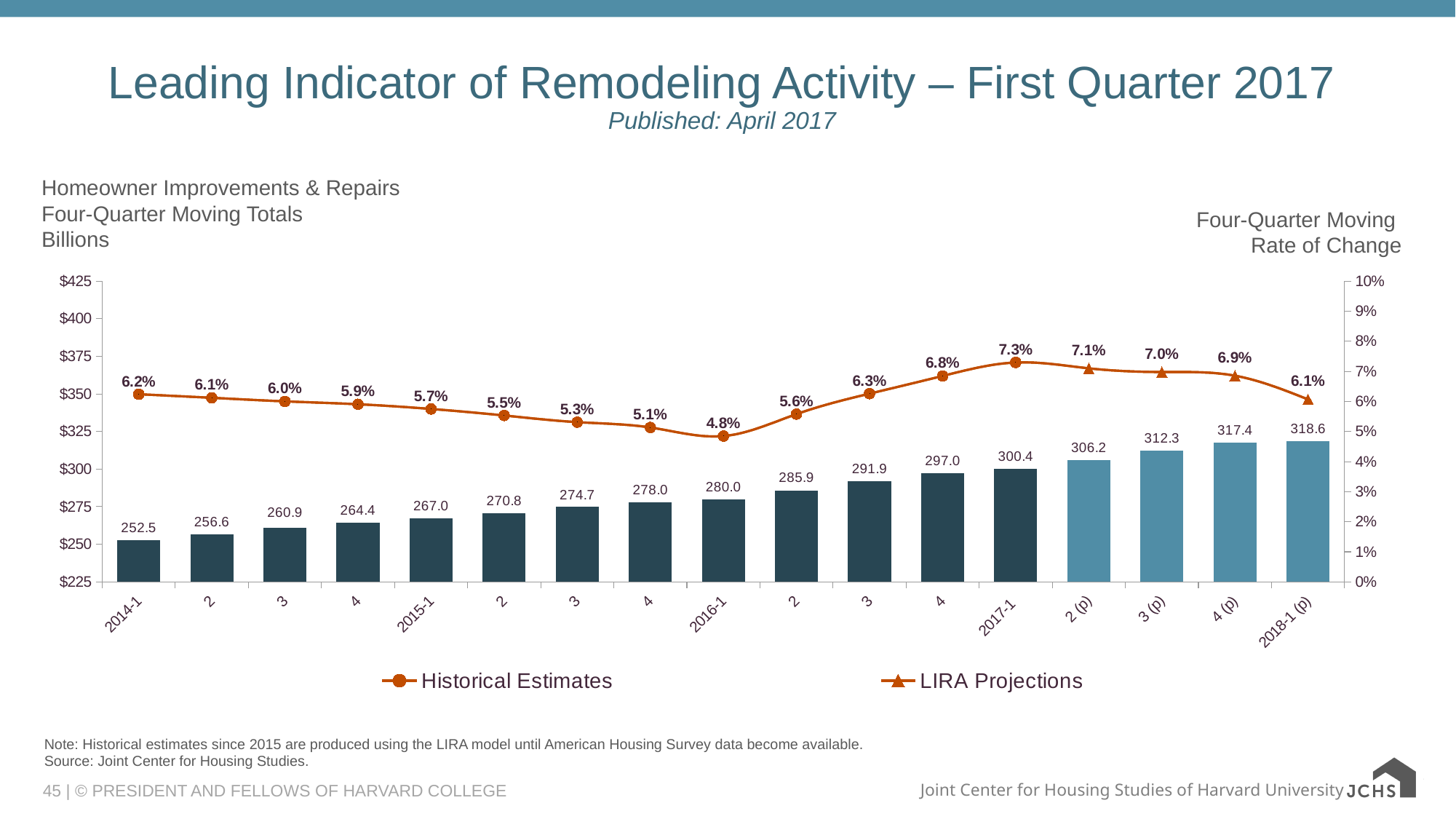
Do the four-quarter moving total bars rise or fall from 2014-1 to 2018-1 (p)? Rise What kind of chart is shown on the slide? Combined bar and line chart Is the four-quarter moving total bar for 2014-1 greater or less than $275? less Which quarter has the highest four-quarter moving rate of change? 2017-1 What is the difference between the four-quarter moving totals for 2018-1 (p) and 2017-1? 18.2 Which is larger, the rate of change for 2015-3 or for 2016-2? 2016-2 Which quarter has the lowest four-quarter moving rate of change? 2016-1 What is the four-quarter moving rate of change shown for 2017-1? 7.3% How many series does the legend list? 2 How many quarters are plotted along the x axis? 17 What is the four-quarter moving total for 2016-1? 280.0 Which quarter has the highest four-quarter moving total bar? 2018-1 (p)